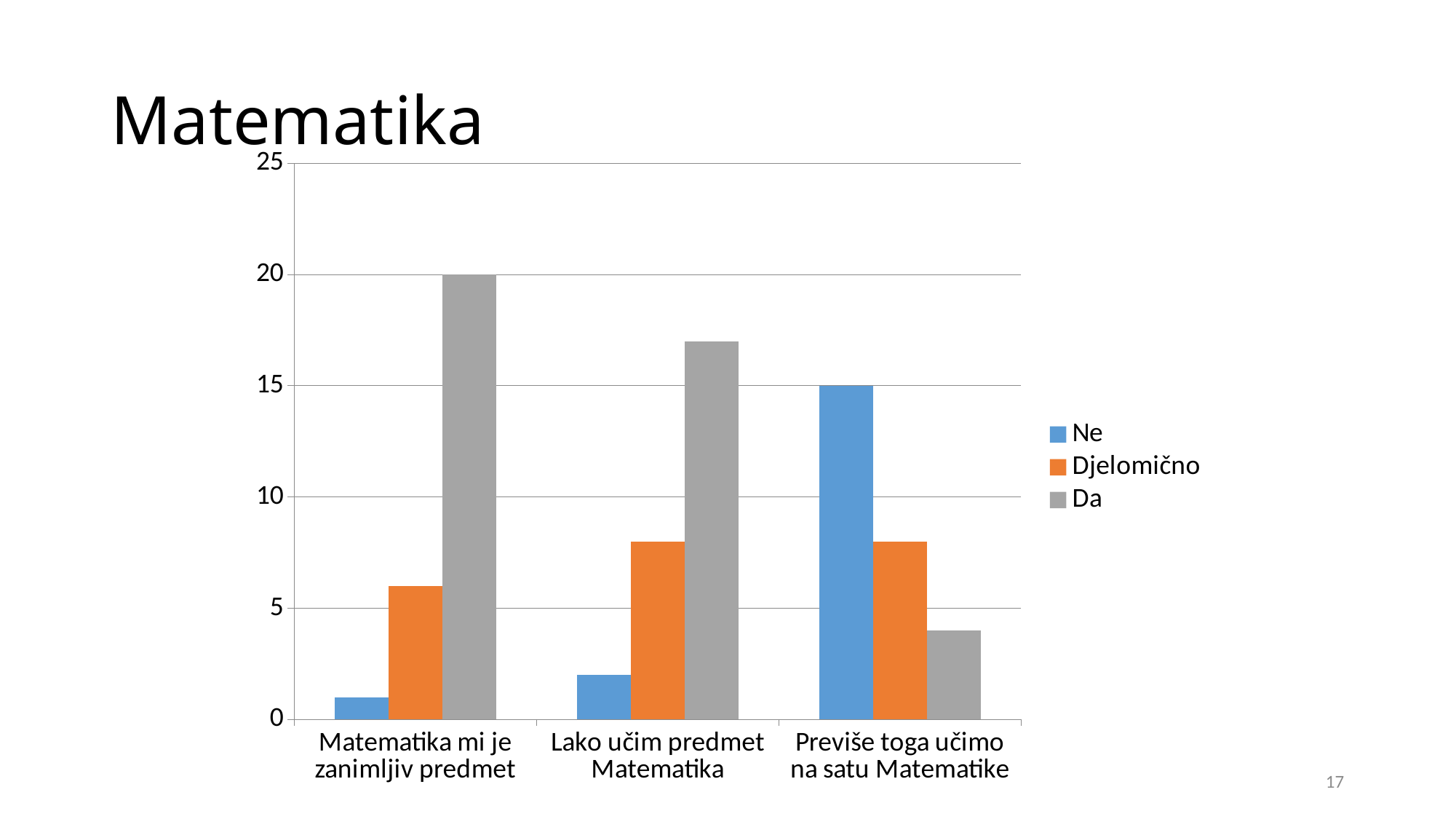
Is the value of "Djelomično" for "Lako učim predmet Matematika" greater or less than 10? less How many categories are shown on the x axis? 3 What is the value of "Da" for "Matematika mi je zanimljiv predmet"? 20 Which category has the highest "Da" value? Matematika mi je zanimljiv predmet Which is larger for "Matematika mi je zanimljiv predmet": "Djelomično" or "Da"? Da Is the value of "Da" for "Lako učim predmet Matematika" greater or less than 15? greater What is the title of the slide? Matematika Which category has the lowest "Ne" value? Matematika mi je zanimljiv predmet What is the value of "Ne" for "Previše toga učimo na satu Matematike"? 15 Which is larger for "Previše toga učimo na satu Matematike": "Ne" or "Da"? Ne How many series does the legend list? 3 What kind of chart is shown on the slide? bar chart